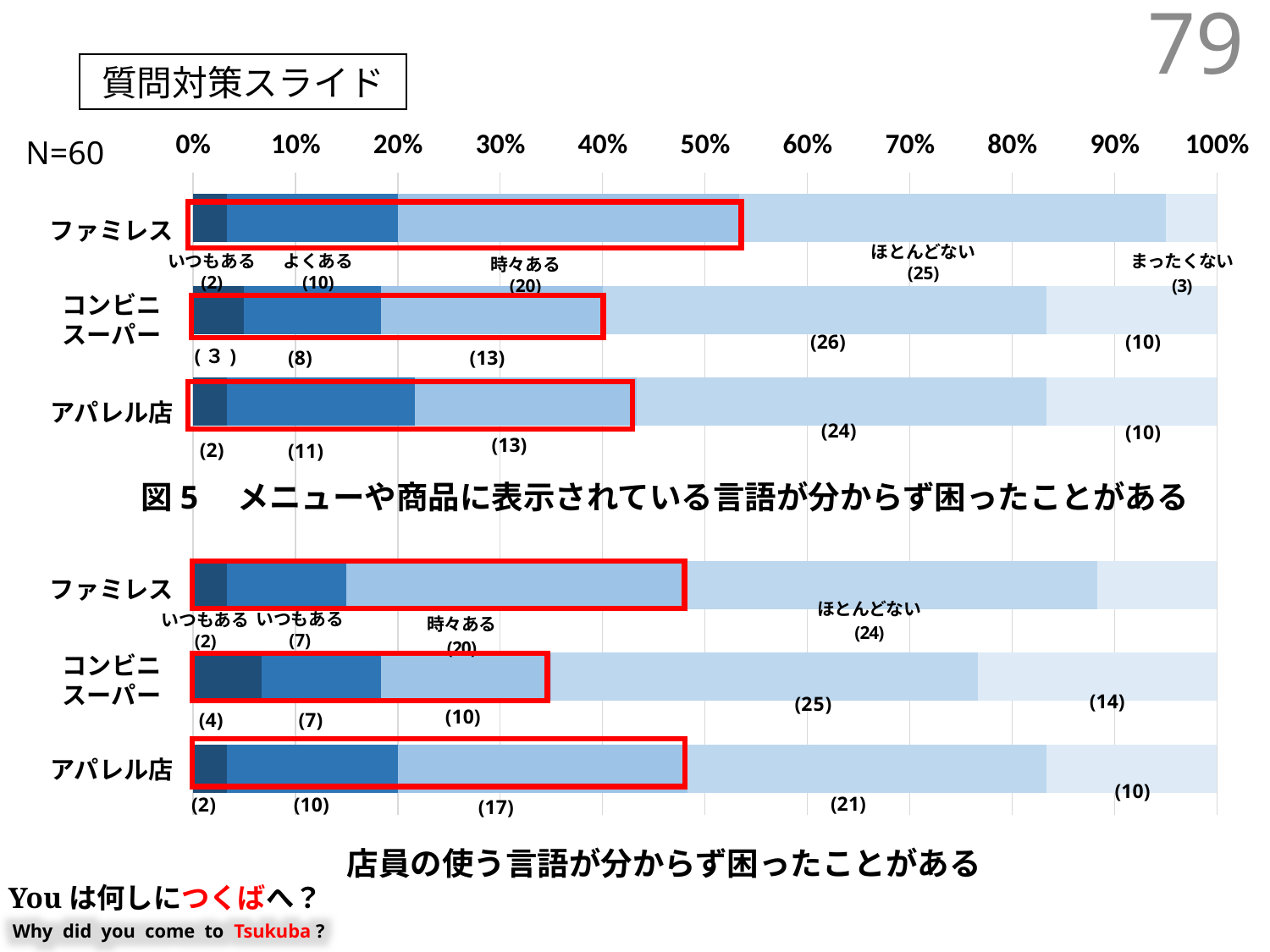
In the bottom chart (店員の使う言語が分からず困ったことがある), which category has the highest count for ほとんどない? コンビニスーパー In the top chart (図5), how many respondents in ファミレス answered 時々ある? 20 How many categories (store types) are shown in the bottom chart 店員の使う言語が分からず困ったことがある? 3 In the bottom chart (店員の使う言語が分からず困ったことがある), how many respondents in アパレル店 answered 時々ある? 17 In the bottom chart (店員の使う言語が分からず困ったことがある), is the ほとんどない count for アパレル店 larger or smaller than that for ファミレス? Smaller In the top chart (図5), which category has the lowest count for まったくない? ファミレス In the bottom chart (店員の使う言語が分からず困ったことがある), how many respondents in コンビニスーパー answered まったくない? 14 In the top chart (図5), what is the difference between the ほとんどない counts for コンビニスーパー and アパレル店? 2 What kind of chart is used for 図5 メニューや商品に表示されている言語が分からず困ったことがある? Stacked bar chart In the top chart (図5), how many respondents in アパレル店 answered よくある? 11 In the top chart (図5), which category has the highest count for まったくない? コンビニスーパー and アパレル店 (10 each) In the top chart (図5), how many respondents in コンビニスーパー answered ほとんどない? 26